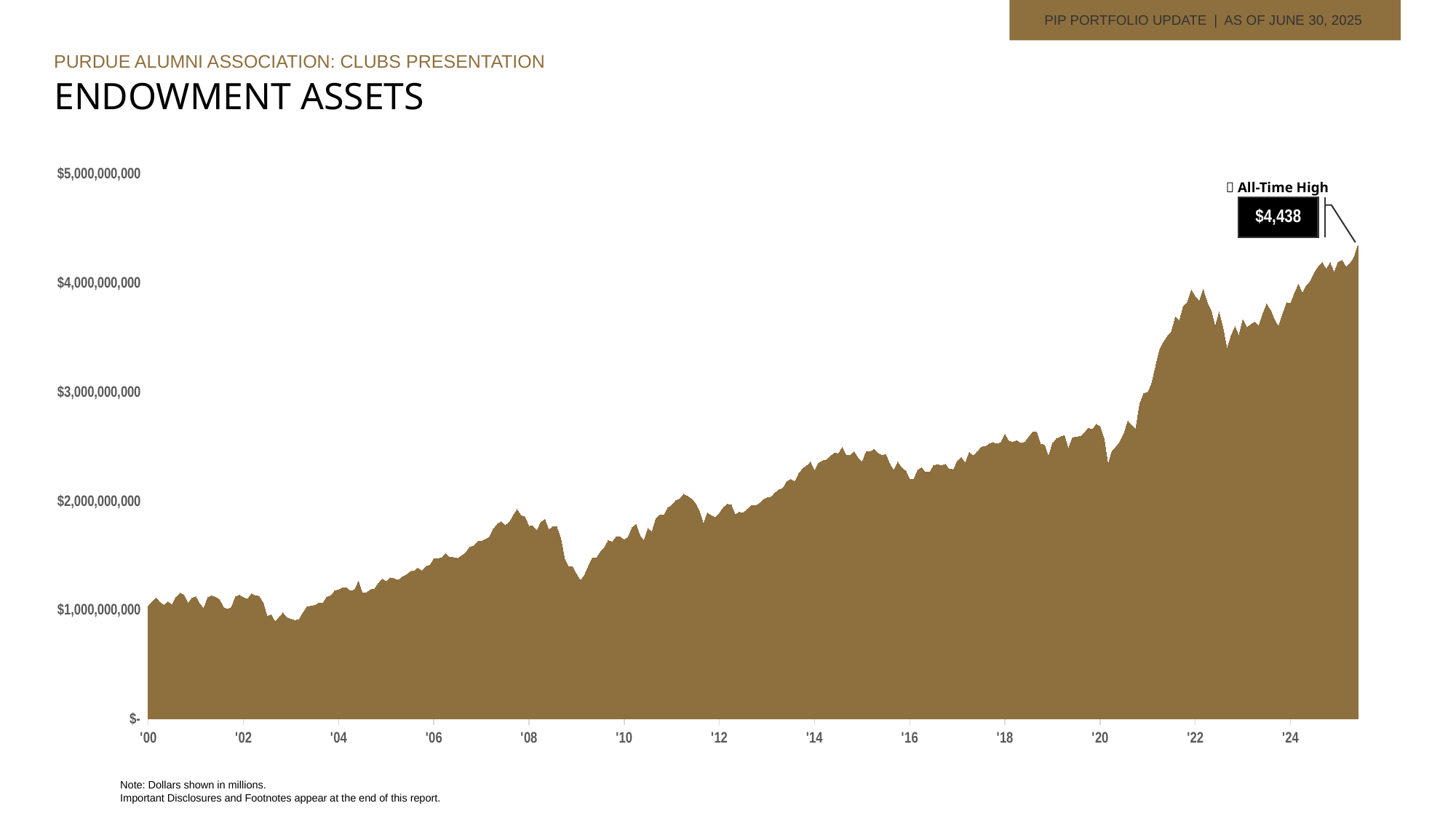
Is the value at '18 greater or less than $3,000,000,000? less What is the title of the chart on the slide? ENDOWMENT ASSETS What kind of chart is shown on the slide? area chart Is the value at '22 greater or less than $3,000,000,000? greater Is the value at '08 greater or less than $2,000,000,000? less Overall, do endowment assets rise or fall from '00 to the end of the chart? rise What is the highest value shown on the y axis? $5,000,000,000 How many year labels are shown on the x axis? 13 What is the all-time high value labelled on the chart? $4,438